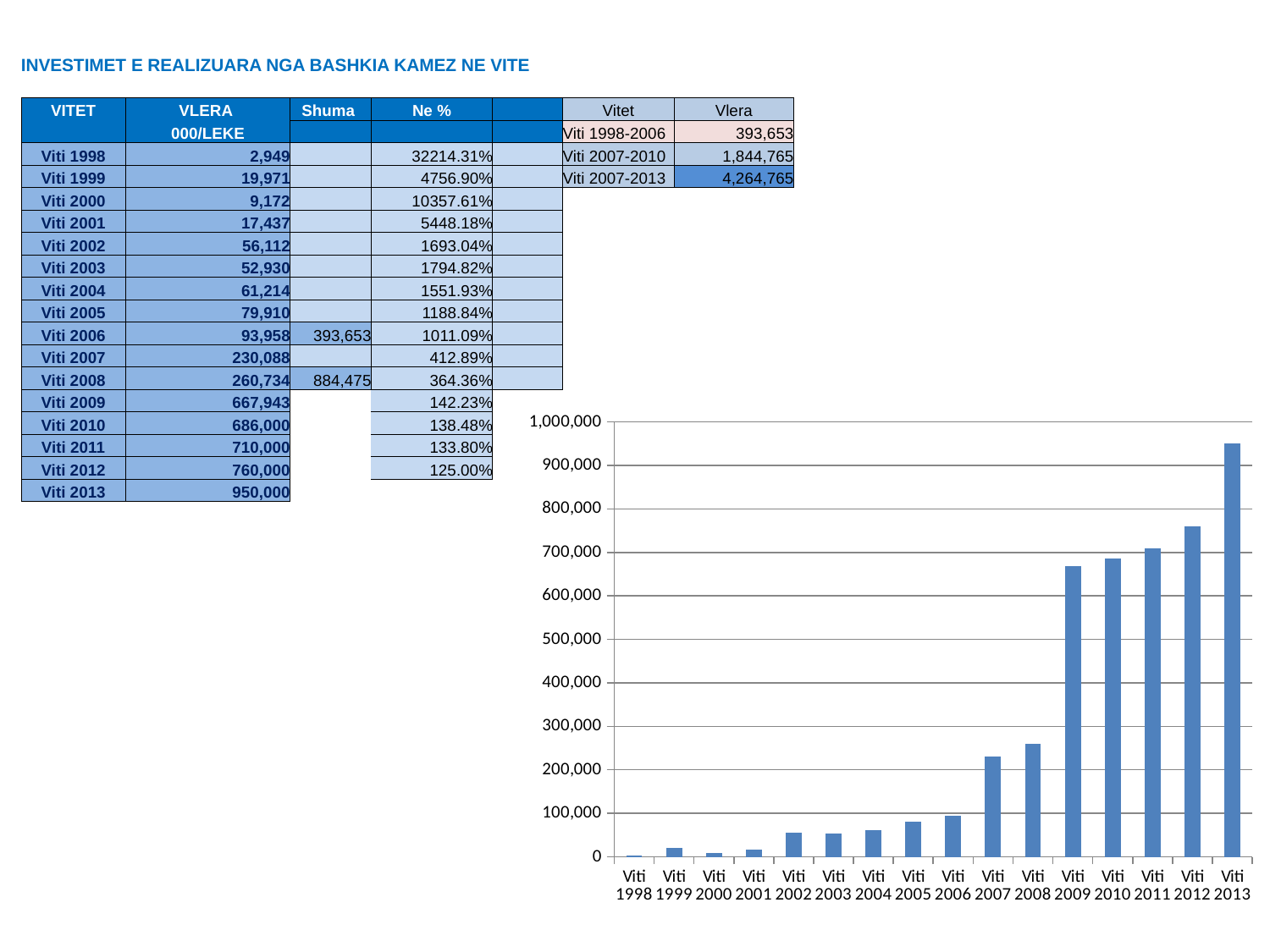
Using the table values, what is the difference between Viti 2013 and Viti 2012? 190,000 Do the bar values generally rise or fall from Viti 1998 to Viti 2013? rise According to the table, what is the value (000/LEKE) for Viti 2013? 950,000 What kind of chart is shown on the slide? bar chart Which year has the highest bar in the chart? Viti 2013 Which is larger, the bar for Viti 2012 or the bar for Viti 2011? Viti 2012 Is the value for Viti 2013 greater or less than 900,000? greater How many years (bars) are plotted in the chart? 16 Which year has the lowest bar in the chart? Viti 1998 Which is larger, the bar for Viti 2008 or the bar for Viti 2007? Viti 2008 Is the value for Viti 2009 greater or less than 600,000? greater Is the value for Viti 2006 greater or less than 100,000? less